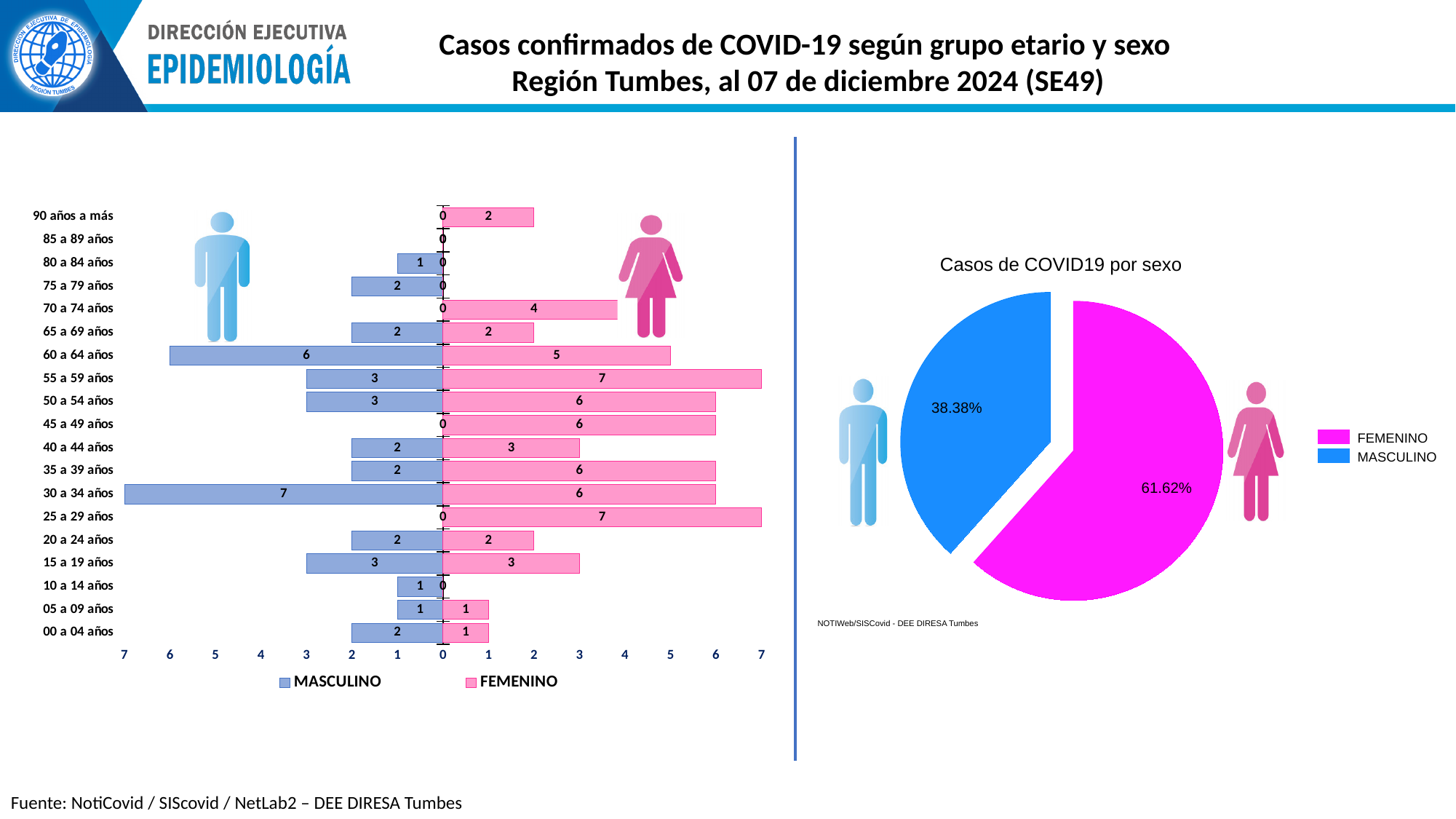
In the left bar chart, how many MASCULINO cases are in the 30 a 34 años group? 7 In the left bar chart, which is larger for the 50 a 54 años group, MASCULINO or FEMENINO? FEMENINO In the left bar chart, what is the total of MASCULINO and FEMENINO cases for the 30 a 34 años group? 13 In the left bar chart, how many FEMENINO cases are in the 70 a 74 años group? 4 In the pie chart 'Casos de COVID19 por sexo', which slice is smaller, FEMENINO or MASCULINO? MASCULINO In the pie chart 'Casos de COVID19 por sexo', what share is FEMENINO? 61.62% In the left bar chart, which age group has the highest MASCULINO value? 30 a 34 años In the left bar chart, how many FEMENINO cases are in the 55 a 59 años group? 7 How many age groups are shown in the left bar chart? 19 How many series does the legend of the left bar chart list? 2 In the left bar chart, what is the difference between the FEMENINO and MASCULINO values for the 60 a 64 años group? 1 What kind of chart is the chart titled 'Casos de COVID19 por sexo'? Pie chart